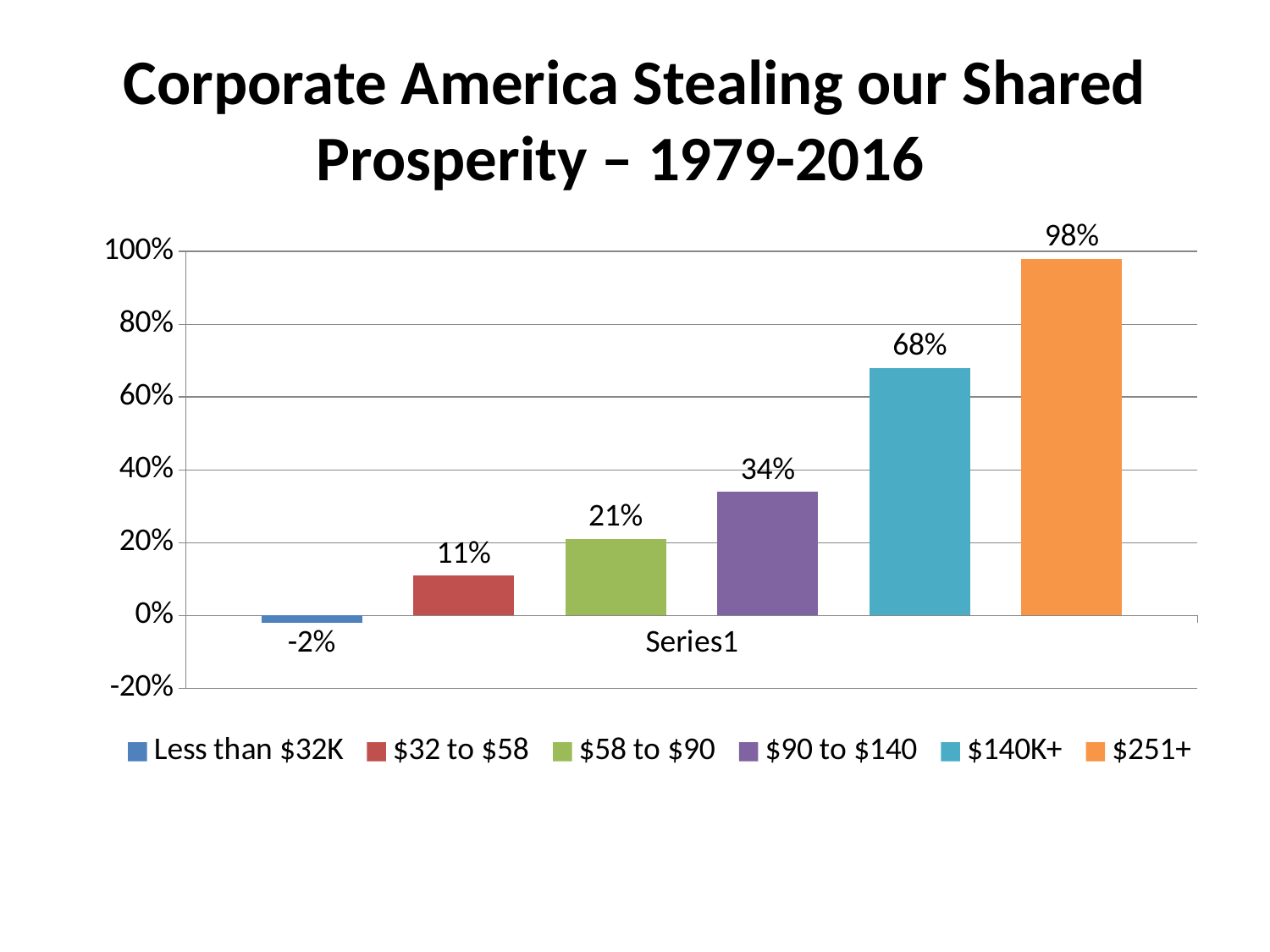
What is the difference between the values for $140K+ and $58 to $90? 47% Is the value for $140K+ greater or less than 60%? greater Which is larger, the value for $32 to $58 or the value for $58 to $90? $58 to $90 Do the values rise or fall moving from left to right across the bars? rise What is the value for the $251+ group? 98% What kind of chart is shown on the slide? bar chart How many entries does the legend list? 6 How many bars are plotted on the chart? 6 Which income group has the lowest value? Less than $32K Which income group has the highest value? $251+ What is the value for the $90 to $140 group? 34% What is the value for the Less than $32K group? -2%